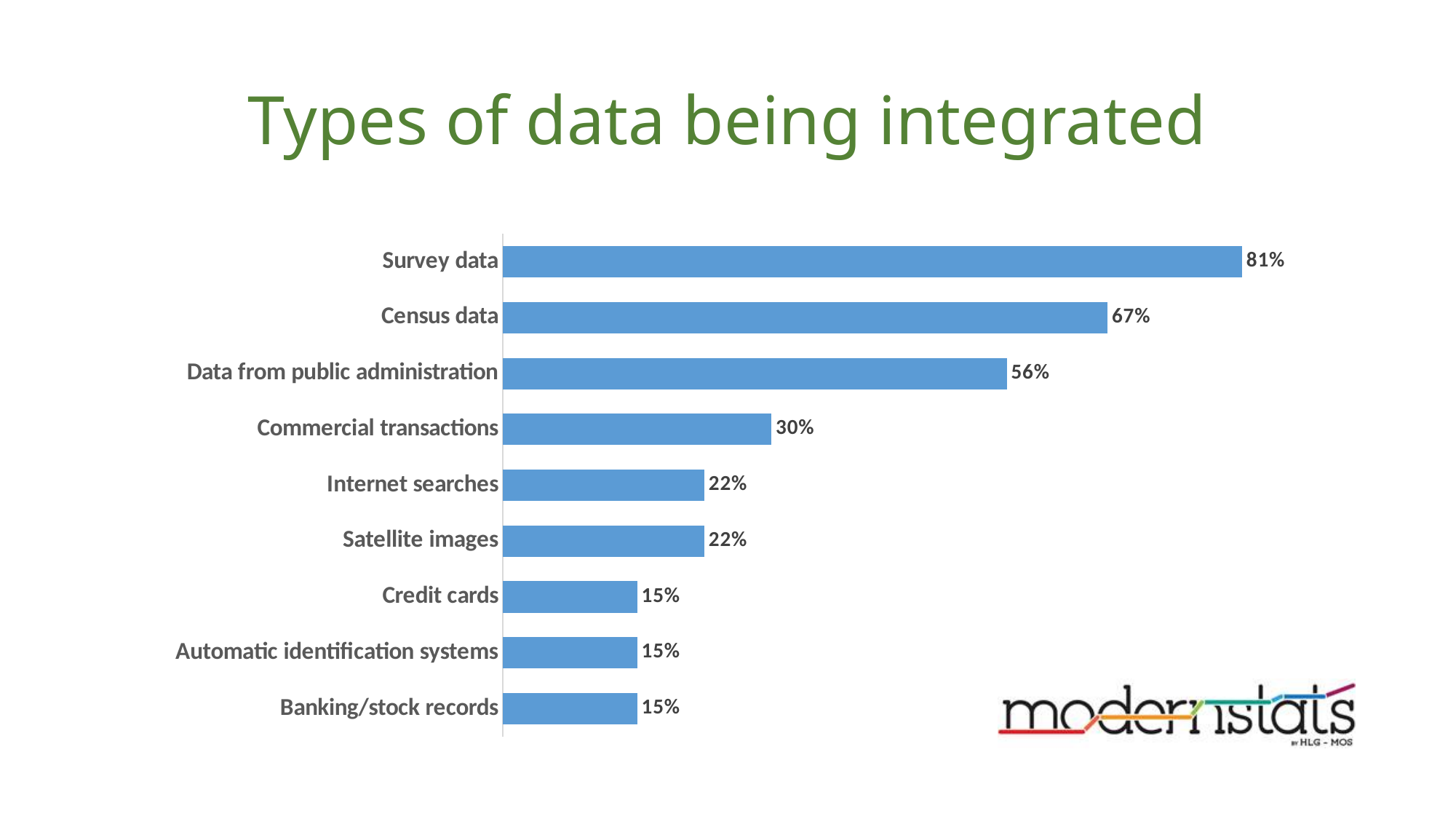
Which is larger, the value for Census data or the value for Data from public administration? Census data Which category has the highest value? Survey data How many categories are shown in the chart? 9 What is the value for Data from public administration? 56% What is the value for Survey data? 81% What kind of chart is shown on the slide? Bar chart How many categories have a value of 15%? 3 What is the value for Satellite images? 22% What is the difference between the values for Survey data and Census data? 14% What is the title of the slide? Types of data being integrated What is the value for Commercial transactions? 30% What is the difference between the values for Commercial transactions and Internet searches? 8%